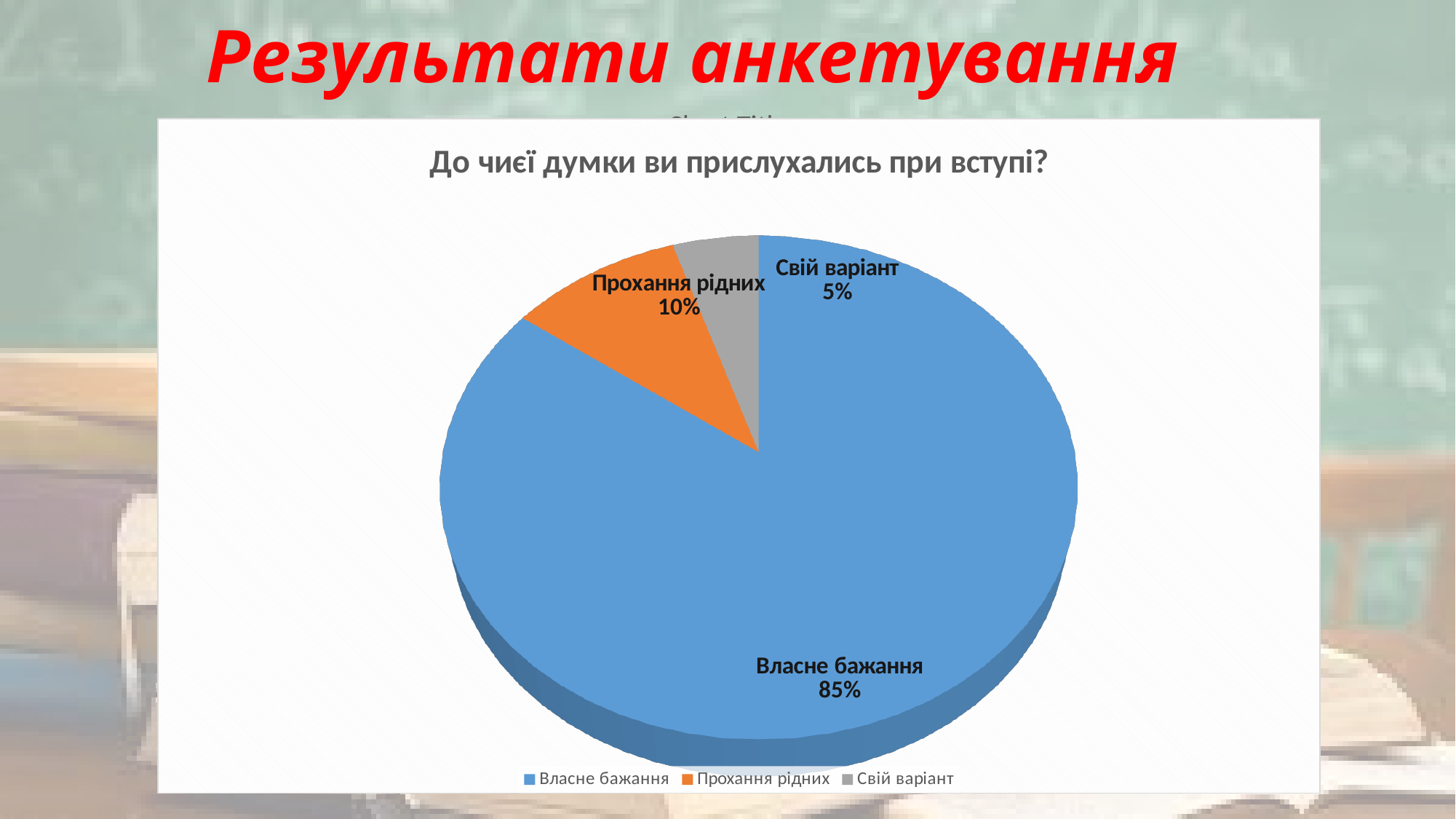
What share of the pie does "Свій варіант" take? 5% What is the title of the chart? До чиєї думки ви прислухались при вступі? What colour is the slice for "Прохання рідних"? Orange Which category has the smallest slice of the pie? Свій варіант What share of the pie does "Прохання рідних" take? 10% Which category has the largest slice of the pie? Власне бажання What kind of chart is shown on the slide? Pie chart What is the difference in percentage points between "Прохання рідних" and "Свій варіант"? 5 What is the difference in percentage points between "Власне бажання" and "Прохання рідних"? 75 What share of the pie does "Власне бажання" take? 85% How many slices does the pie chart have? 3 Which is larger, the slice for "Прохання рідних" or the slice for "Свій варіант"? Прохання рідних